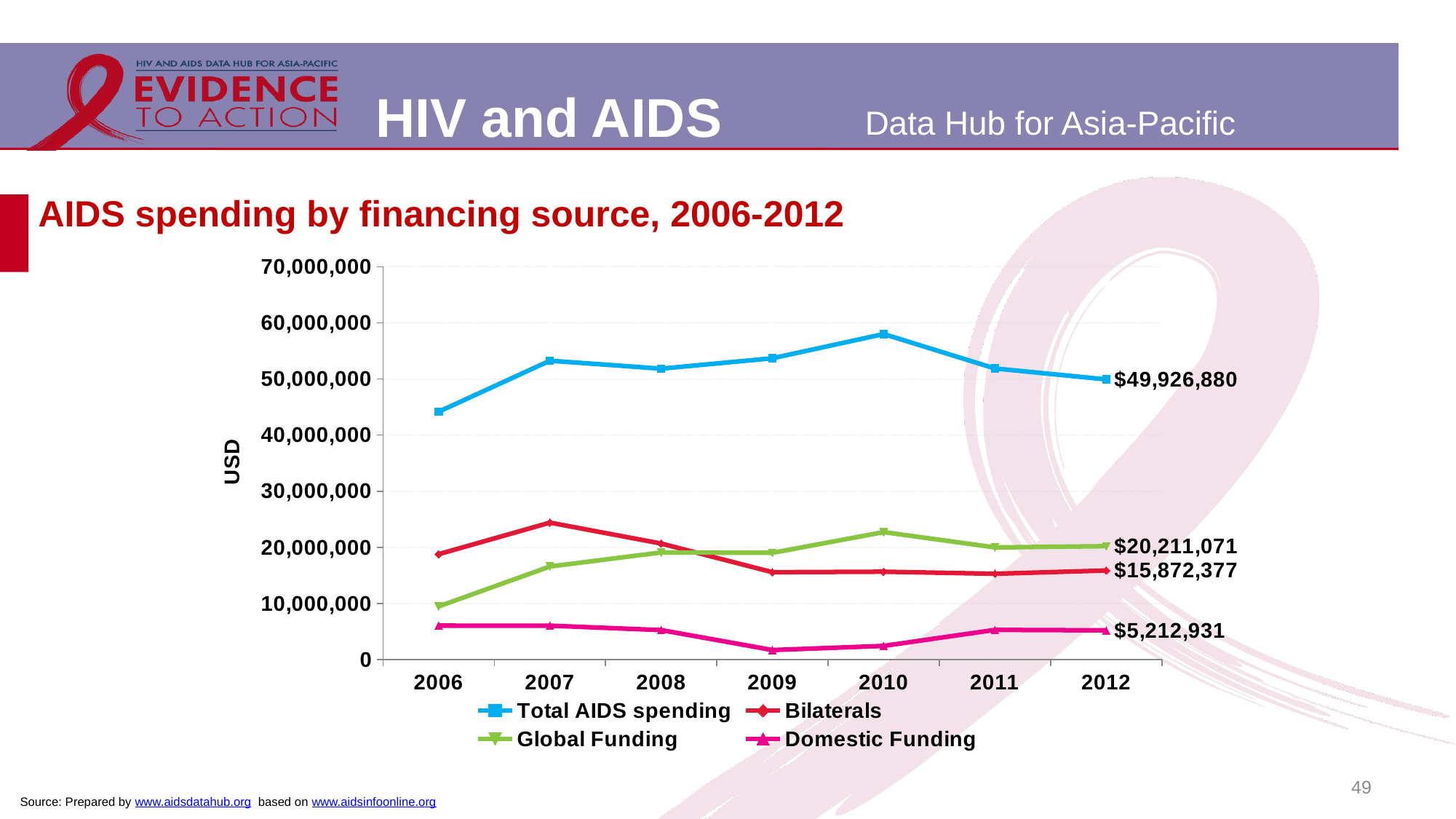
How many series does the legend list? 4 Is the value for Total AIDS spending in 2006 greater or less than 50,000,000? less In 2012, how much larger is Global Funding than Bilaterals? $4,338,694 In 2007, which is larger: Bilaterals or Global Funding? Bilaterals What kind of chart is shown on the slide? Line chart What is the value for Domestic Funding in 2012? $5,212,931 Is the value for Bilaterals in 2007 greater or less than 20,000,000? greater In which year is Total AIDS spending lowest? 2006 In which year is Total AIDS spending highest? 2010 What is the value for Global Funding in 2012? $20,211,071 What is the value for Bilaterals in 2012? $15,872,377 What is the value for Total AIDS spending in 2012? $49,926,880